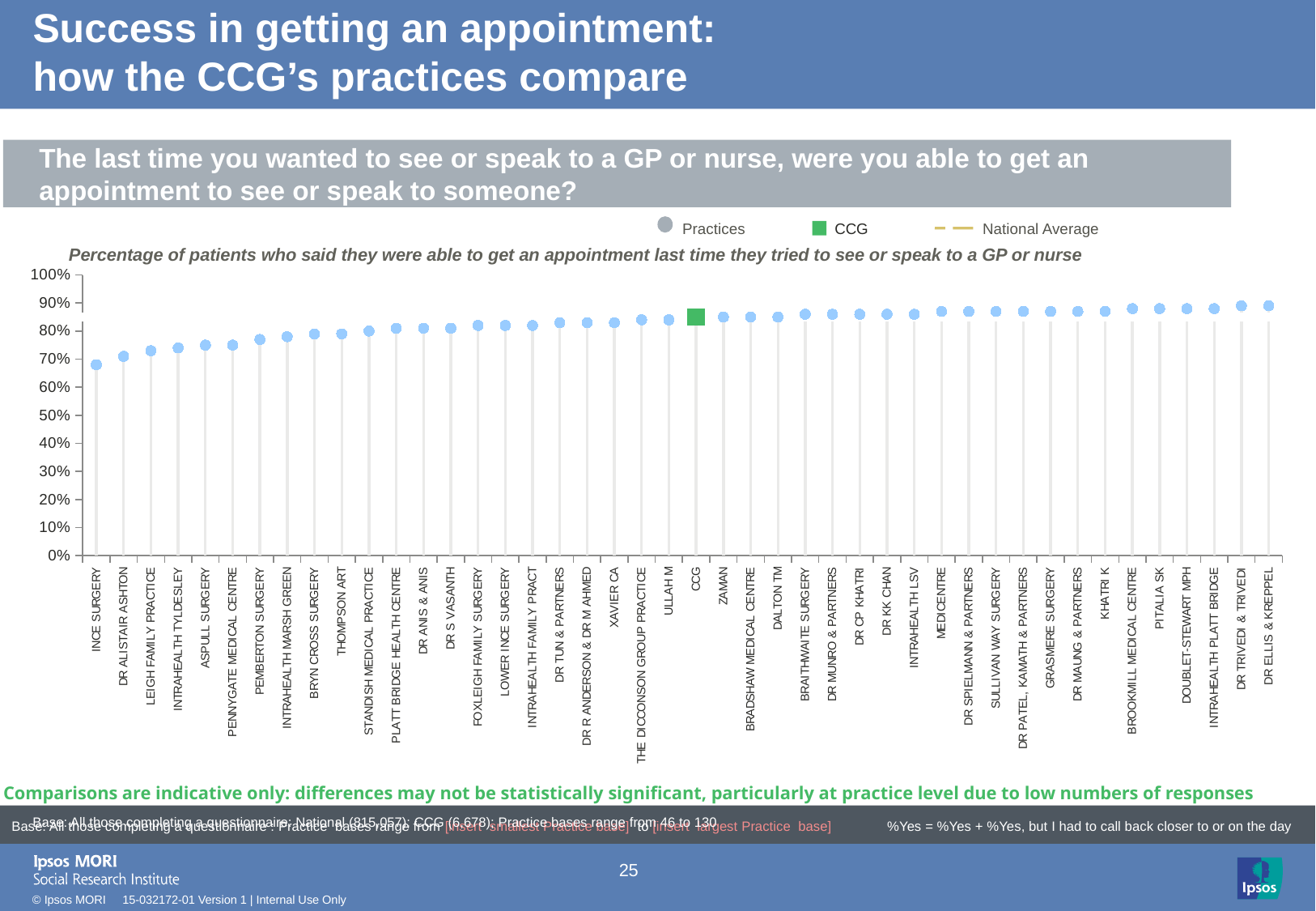
Which practice has the lowest percentage of patients who said they were able to get an appointment? INCE SURGERY Which has the higher value, INCE SURGERY or DR ELLIS & KREPPEL? DR ELLIS & KREPPEL Is the value for DR ALISTAIR ASHTON greater or less than 80%? less Is the value for DR ELLIS & KREPPEL greater or less than 80%? greater How many entries does the legend list? 3 Is the value for CCG greater or less than 80%? greater What is the highest value shown on the y axis? 100% What colour is the marker used for the CCG? green Do the values rise or fall moving from left to right along the x axis? rise Which has the higher value, LEIGH FAMILY PRACTICE or CCG? CCG